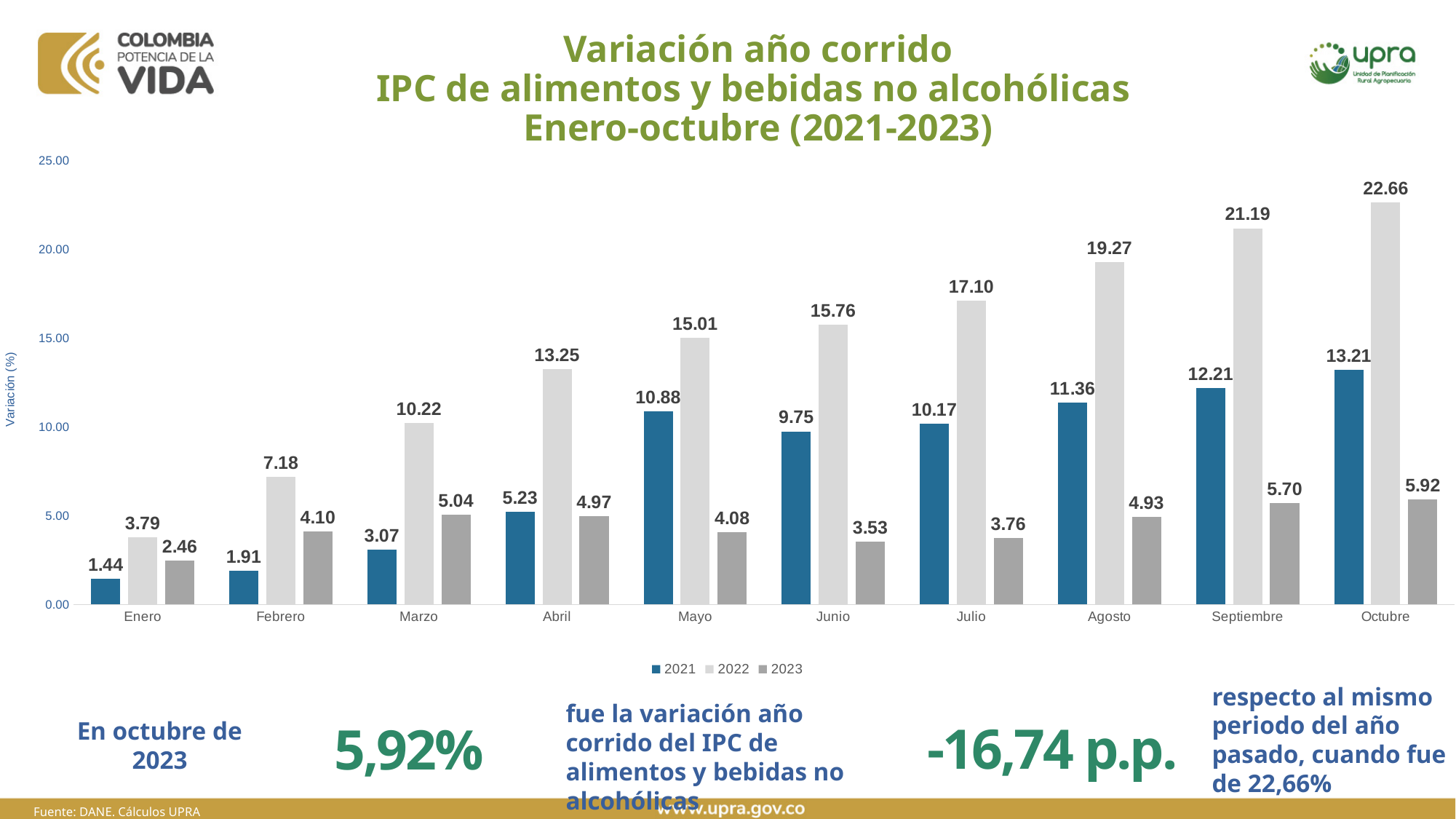
Which month has the lowest value for the 2023 series? Junio What is the value for 2022 in Octubre? 22.66 What kind of chart is shown on the slide? bar chart Which month has the highest value for the 2021 series? Octubre Do the values for the 2022 series rise or fall from Enero to Octubre? rise Is the value for 2022 in Agosto greater or less than 20.00? less How many series does the legend list? 3 What is the difference between the 2022 and 2023 values in Octubre? 16.74 What is the value for 2023 in Marzo? 5.04 What is the label on the y axis of the chart? Variación (%) In Abril, which series has the larger value, 2021 or 2023? 2021 How many months are shown on the x axis? 10